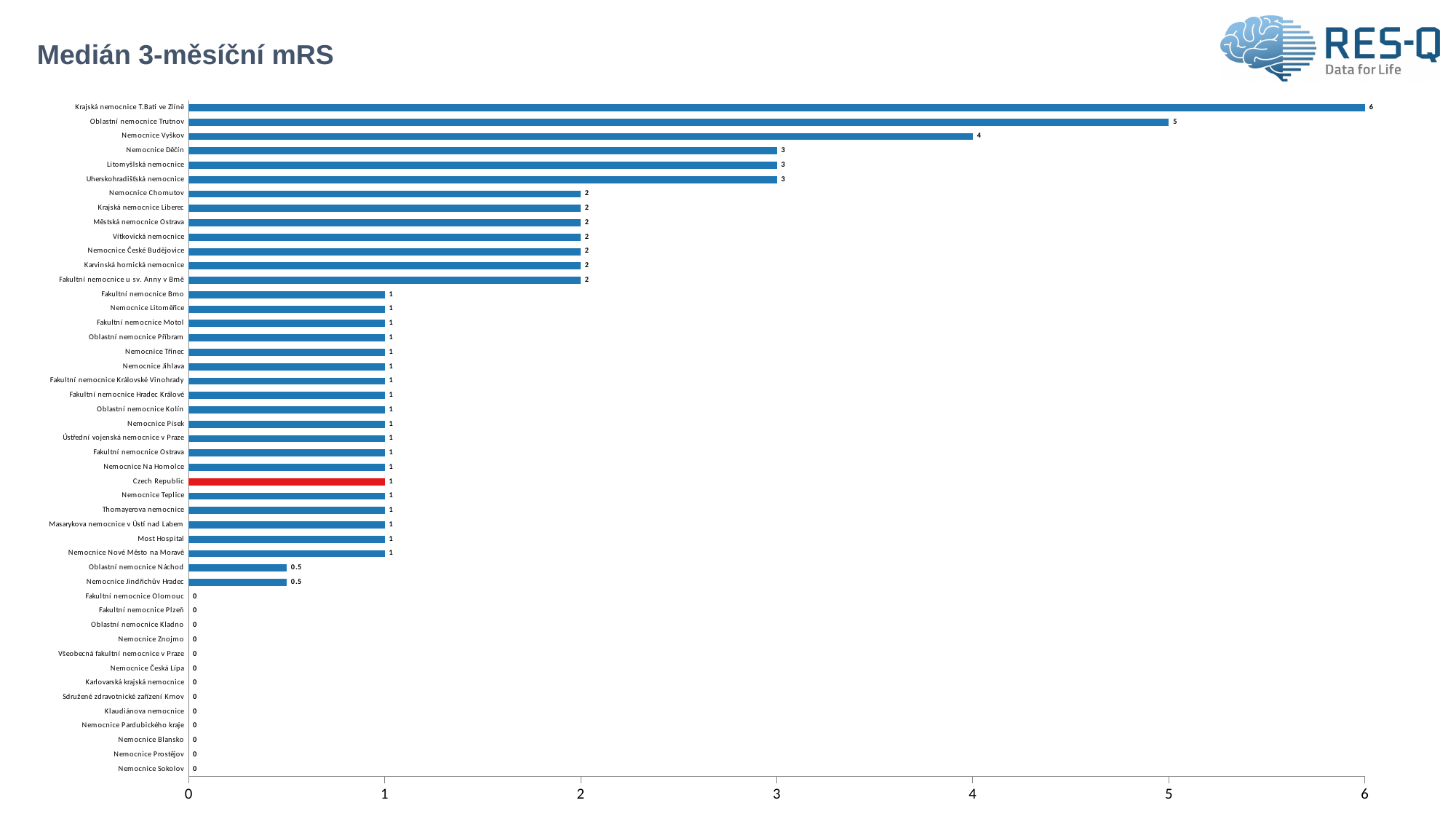
Which bar is highlighted in red? Czech Republic What is the difference between the values for Krajská nemocnice T.Bati ve Zlíně and Oblastní nemocnice Trutnov? 1 What is the value shown for Nemocnice Vyškov? 4 What is the value shown for Oblastní nemocnice Náchod? 0.5 What is the value shown for Oblastní nemocnice Trutnov? 5 What is the median 3-month mRS value for Krajská nemocnice T.Bati ve Zlíně? 6 What is the title of the chart? Medián 3-měsíční mRS What is the value shown for Czech Republic? 1 Which hospital has the highest median 3-month mRS? Krajská nemocnice T.Bati ve Zlíně Which is larger, the value for Nemocnice Chomutov or the value for Fakultní nemocnice Brno? Nemocnice Chomutov What is the difference between the values for Nemocnice Vyškov and Nemocnice Děčín? 1 What type of chart is shown on the slide? bar chart